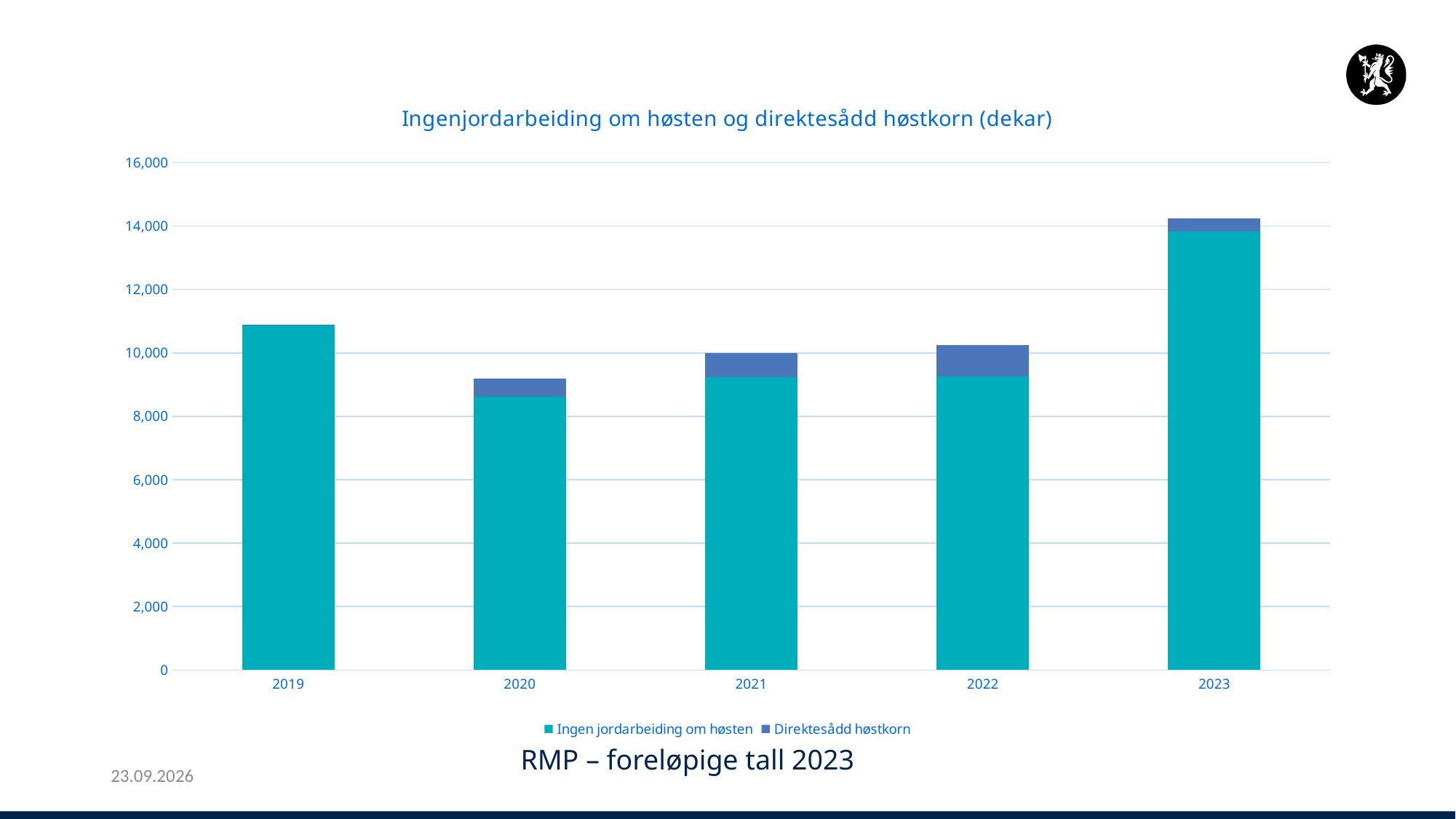
What kind of chart is shown on the slide? Stacked bar chart Which year has the larger 'Direktesådd høstkorn' segment, 2019 or 2022? 2022 Is the 'Ingen jordarbeiding om høsten' value for 2021 greater or less than 10,000? less From 2020 to 2023, do the total bars rise or fall? rise Which year has the larger total bar, 2019 or 2020? 2019 How many years are shown on the x axis of the chart? 5 Is the total bar for 2023 greater or less than 12,000? greater Which year has the highest total bar in the chart? 2023 What is the title of the chart? Ingenjordarbeiding om høsten og direktesådd høstkorn (dekar) How many series does the chart's legend list? 2 Is the total bar for 2020 greater or less than 10,000? less Which year has the lowest total bar in the chart? 2020